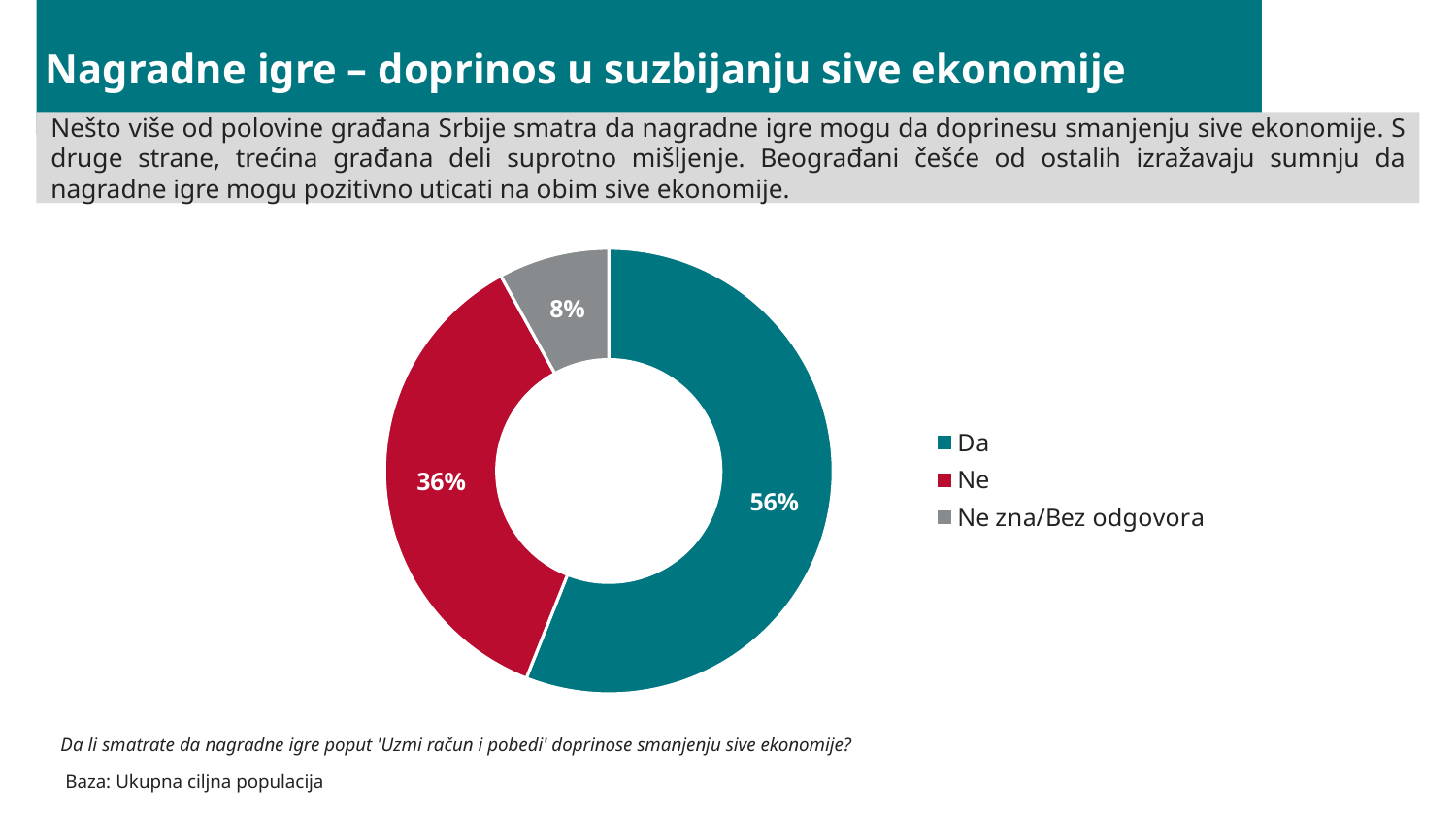
What share of respondents answered "Ne zna/Bez odgovora"? 8% What share of respondents answered "Da"? 56% Which answer has the largest share of the chart? Da Which is larger, the share for "Ne" or the share for "Ne zna/Bez odgovora"? Ne What kind of chart is shown on the slide? Pie chart (doughnut) How many entries does the legend list? 3 What colour is the "Ne" slice? Red What is the title of the slide? Nagradne igre – doprinos u suzbijanju sive ekonomije What is the difference in percentage points between the "Da" and "Ne" shares? 20 Which answer has the smallest share of the chart? Ne zna/Bez odgovora How many categories does the chart show? 3 What share of respondents answered "Ne"? 36%